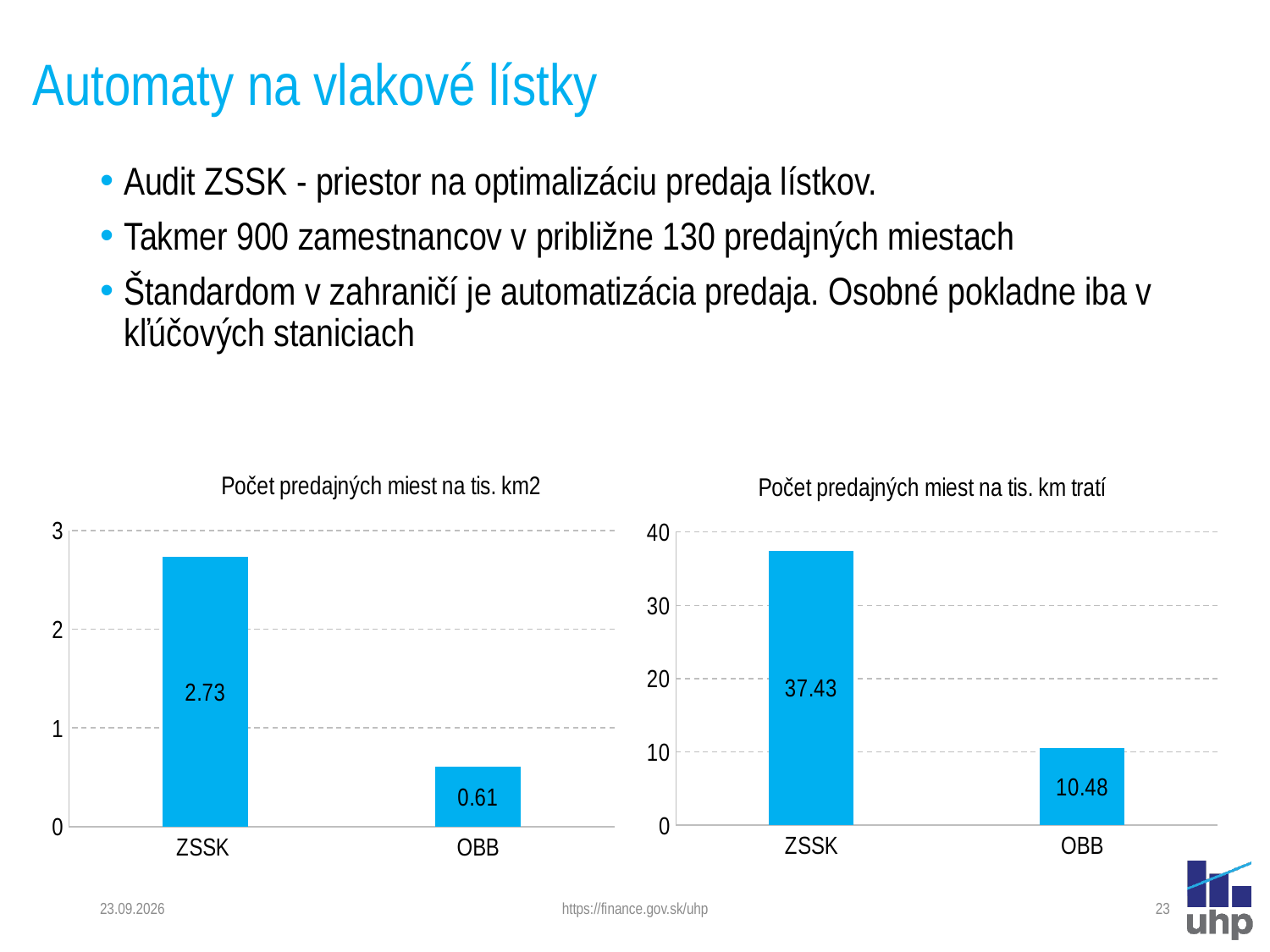
In the chart 'Počet predajných miest na tis. km tratí', which category has the lowest value? OBB What is the title of the chart on the left side of the slide? Počet predajných miest na tis. km2 What kind of chart is 'Počet predajných miest na tis. km tratí'? bar chart In the chart 'Počet predajných miest na tis. km tratí', is the value for ZSSK greater or less than 30? greater In the chart 'Počet predajných miest na tis. km2', which category has the highest value? ZSSK In the chart 'Počet predajných miest na tis. km2', what is the value for ZSSK? 2.73 How many categories are shown in the chart 'Počet predajných miest na tis. km2'? 2 In the chart 'Počet predajných miest na tis. km tratí', what is the value for OBB? 10.48 In the chart 'Počet predajných miest na tis. km2', what is the difference between the values for ZSSK and OBB? 2.12 In the chart 'Počet predajných miest na tis. km2', what is the value for OBB? 0.61 In the chart 'Počet predajných miest na tis. km tratí', what is the value for ZSSK? 37.43 In the chart 'Počet predajných miest na tis. km tratí', what is the difference between the values for ZSSK and OBB? 26.95